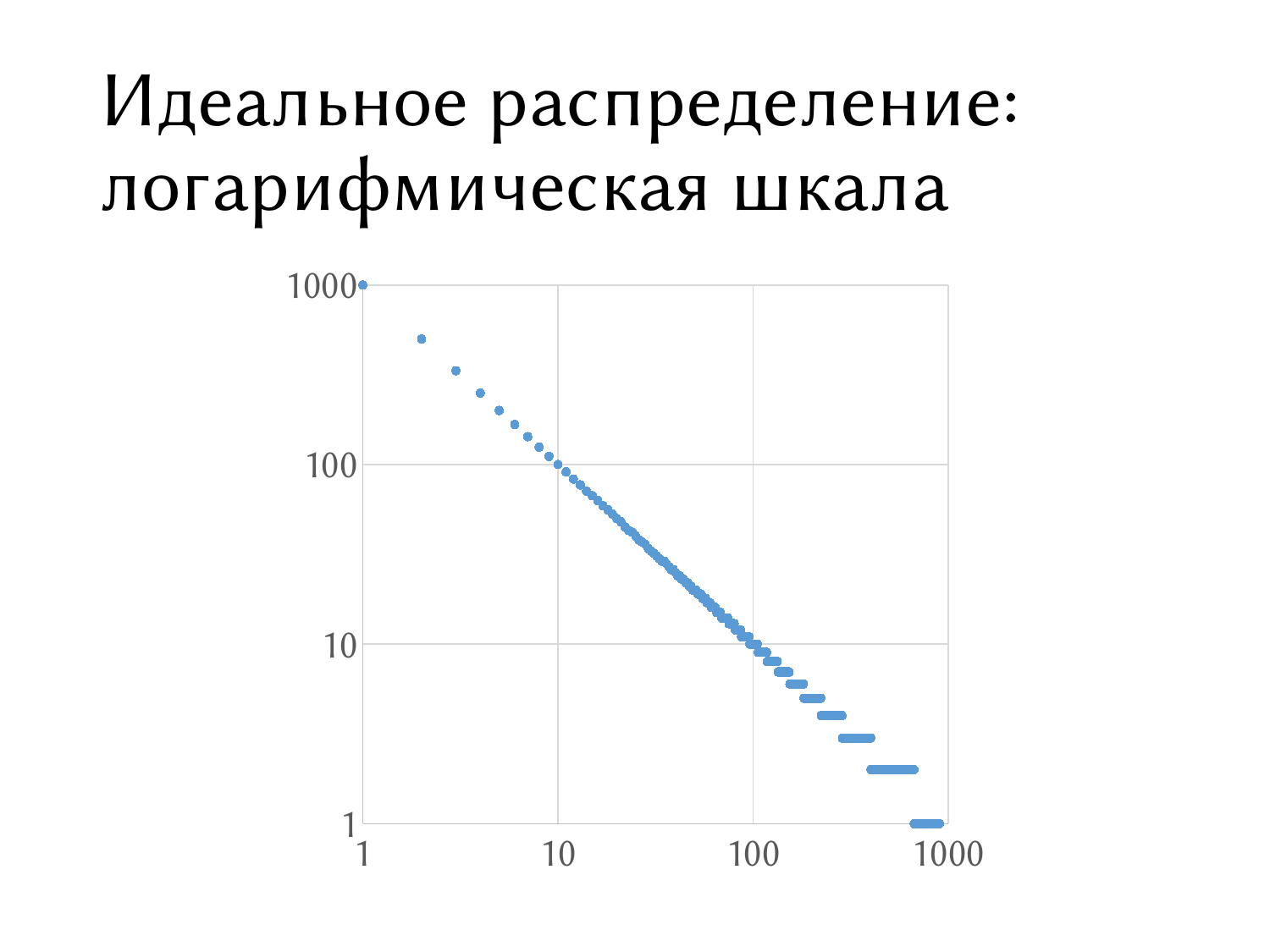
Which has the larger y value: the point at x = 1 or the point at x = 100? the point at x = 1 What is the title of the slide containing the chart? Идеальное распределение: логарифмическая шкала Is the y value of the points near x = 500 greater or less than 10? less What is the highest tick label shown on the y axis? 1000 Is the y value of the point at x = 3 greater or less than 1000? less What is the y value of the point plotted at x = 10? 100 What is the y value of the point plotted at x = 1? 1000 What is the y value of the point plotted at x = 100? 10 Is the y value of the point at x = 2 greater or less than 100? greater Do the plotted values rise or fall as x increases along the x axis? fall What kind of chart is shown on the slide? scatter chart What is the lowest y value reached by the plotted points? 1